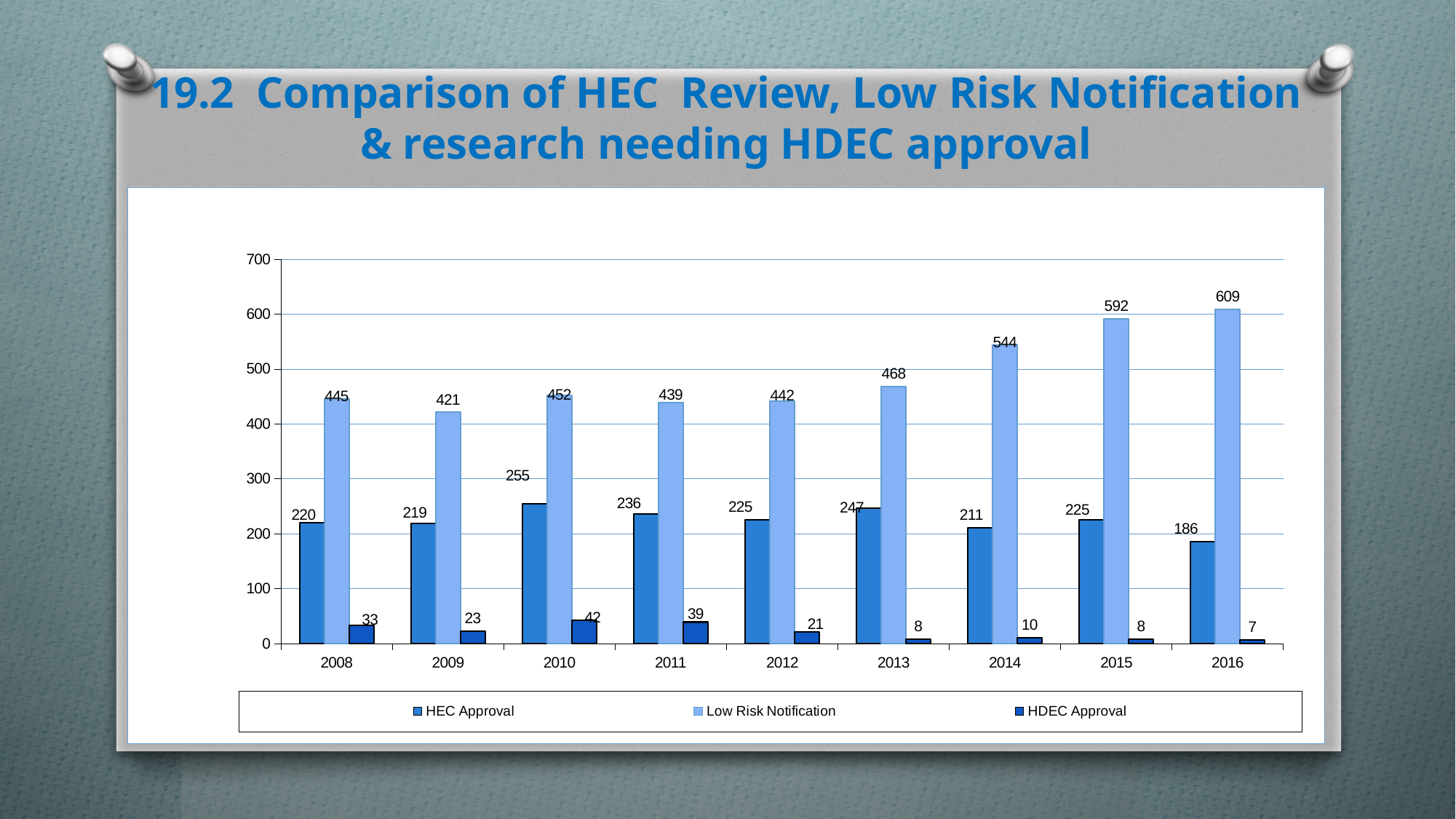
Which year has the lowest HEC Approval value? 2016 Do the Low Risk Notification values rise or fall from 2013 to 2016? Rise How many series does the legend list? 3 What is the HDEC Approval value for 2011? 39 What is the difference between the Low Risk Notification values for 2016 and 2015? 17 What kind of chart is shown on the slide? Bar chart What is the HEC Approval value for 2010? 255 What is the Low Risk Notification value for 2016? 609 How many years are shown on the x axis? 9 Which is larger, the HEC Approval value for 2013 or for 2014? 2013 Which year has the highest HDEC Approval value? 2010 Which year has the highest Low Risk Notification value? 2016